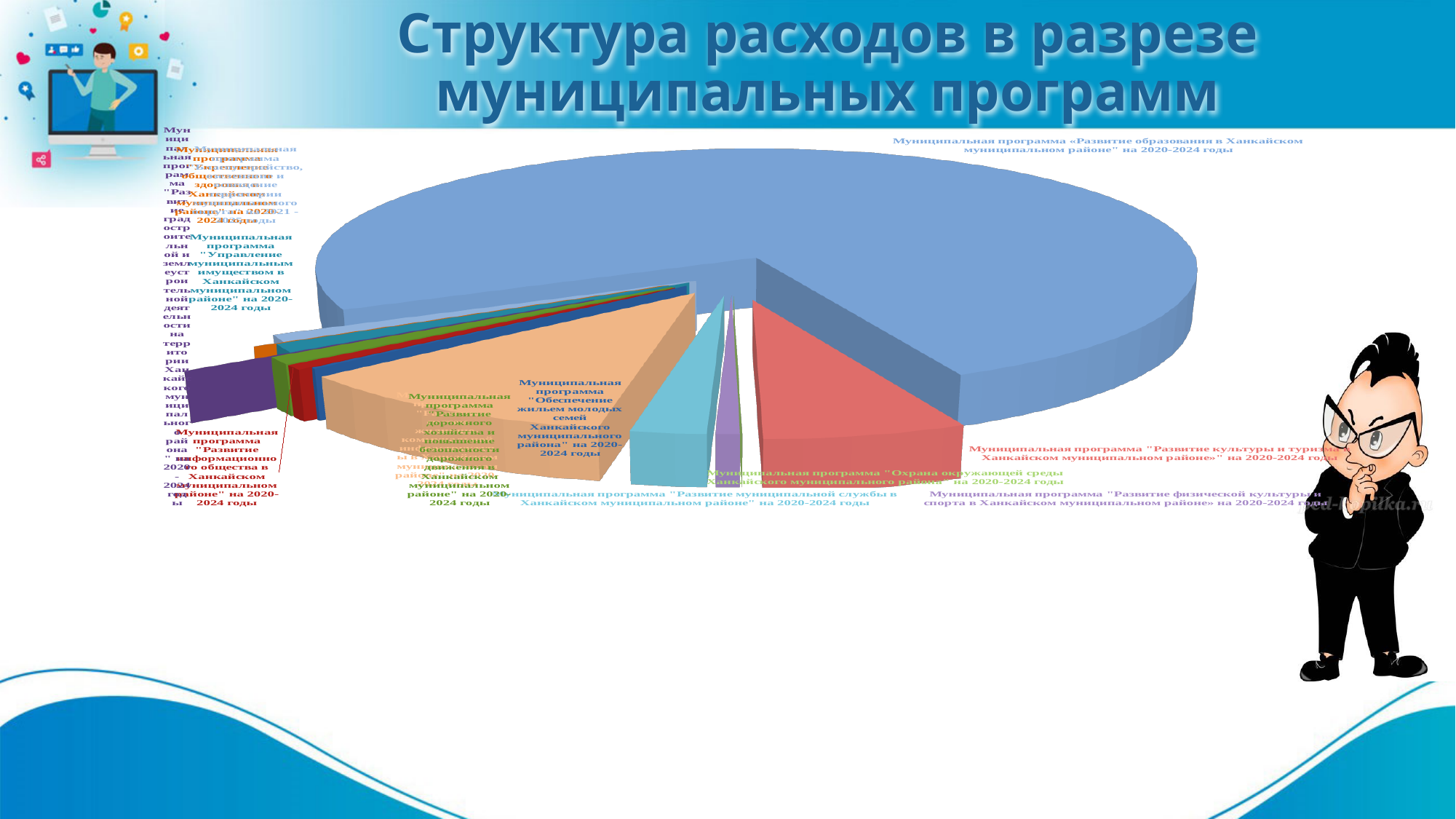
Which slice is larger: the one for "Развитие культуры и туризма в Ханкайском муниципальном районе" or the one for "Охрана окружающей среды Ханкайского муниципального района"? Развитие культуры и туризма в Ханкайском муниципальном районе Which municipal program has the largest slice of the pie chart? Муниципальная программа «Развитие образования в Ханкайском муниципальном районе" на 2020-2024 годы What colour is the largest slice of the pie chart? blue What is the title of the slide containing the pie chart? Структура расходов в разрезе муниципальных программ Which slice is larger: the one for «Развитие образования в Ханкайском муниципальном районе» or the one for "Развитие культуры и туризма в Ханкайском муниципальном районе"? Развитие образования в Ханкайском муниципальном районе What kind of chart is shown on the slide? pie chart